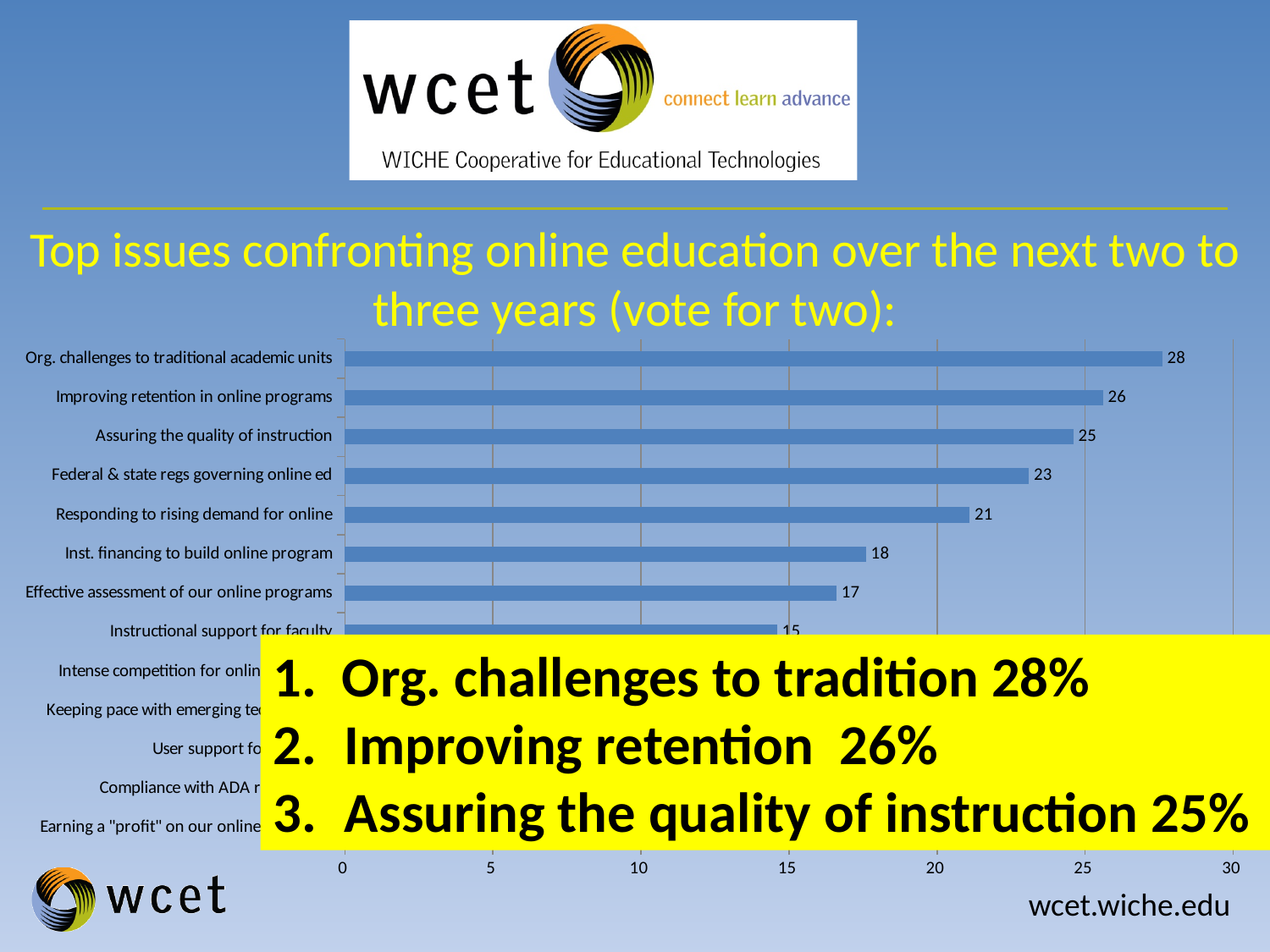
What is the difference between the values for "Responding to rising demand for online" and "Effective assessment of our online programs"? 4 Is the value for "Effective assessment of our online programs" greater or less than 20? less What value is shown for "Federal & state regs governing online ed"? 23 What is the difference between the values for "Org. challenges to traditional academic units" and "Improving retention in online programs"? 2 What kind of chart is shown on the slide? bar chart What value is shown for "Assuring the quality of instruction"? 25 What value is shown for "Improving retention in online programs"? 26 What value is shown for "Org. challenges to traditional academic units"? 28 Which is larger: the value for "Federal & state regs governing online ed" or the value for "Responding to rising demand for online"? Federal & state regs governing online ed What is the title of the chart? Top issues confronting online education over the next two to three years (vote for two): Which category has the highest value in the chart? Org. challenges to traditional academic units What value is shown for "Inst. financing to build online program"? 18